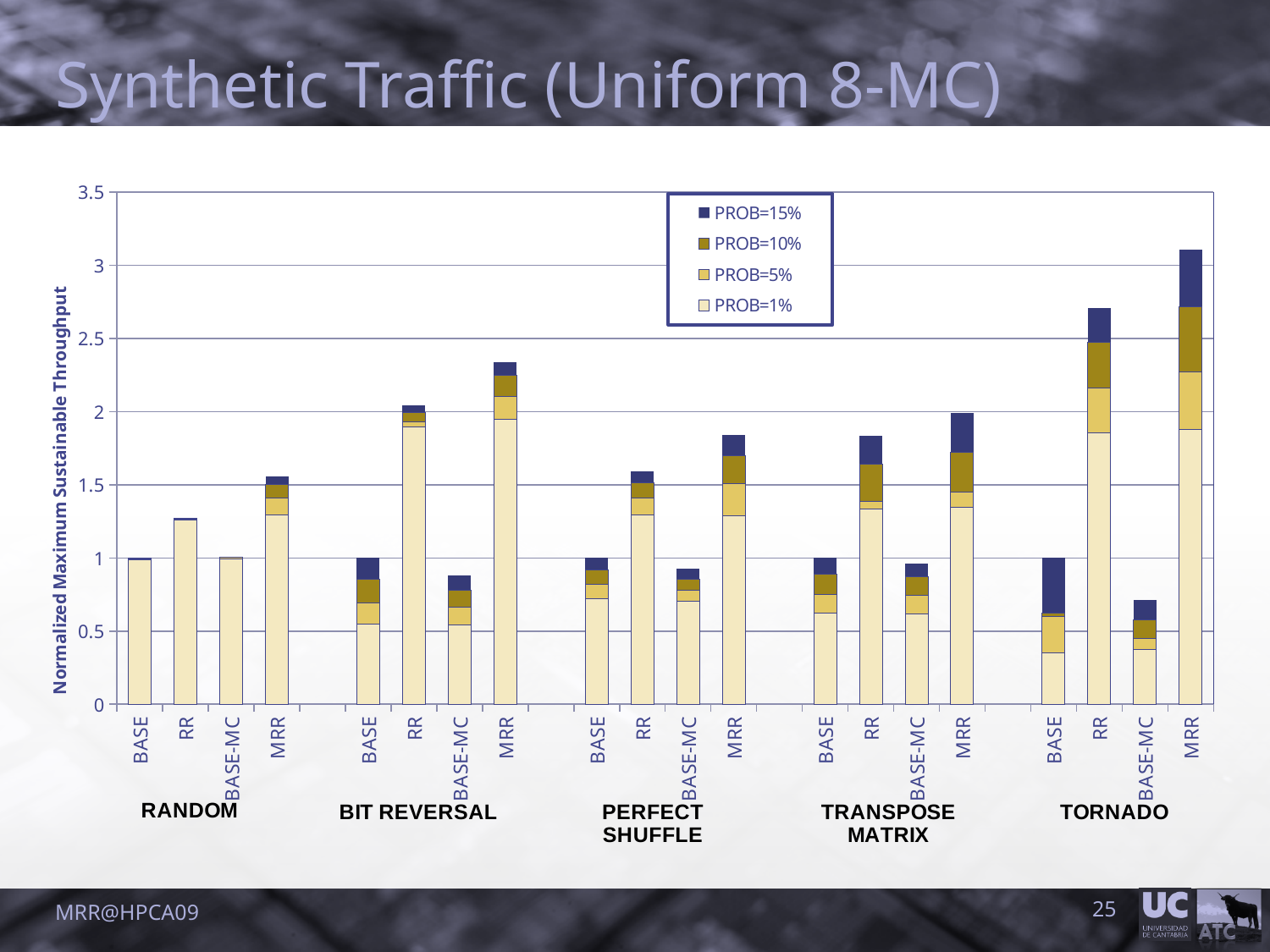
How many series does the legend list? 4 How many traffic pattern groups are shown along the x axis? 5 Is the total value for MRR under TORNADO greater or less than 3? greater Which bar has the lowest total Normalized Maximum Sustainable Throughput? BASE-MC under TORNADO What is the label of the y axis? Normalized Maximum Sustainable Throughput Is the total value for MRR under BIT REVERSAL greater or less than 2? greater Which has a larger total value: MRR under TORNADO or MRR under BIT REVERSAL? MRR under TORNADO How many bars are plotted in the chart? 20 What kind of chart is shown on the slide? Stacked bar chart Which bar has the highest total Normalized Maximum Sustainable Throughput? MRR under TORNADO Is the total value for RR under RANDOM greater or less than 1.5? less Which has a larger total value: RR under BIT REVERSAL or MRR under RANDOM? RR under BIT REVERSAL